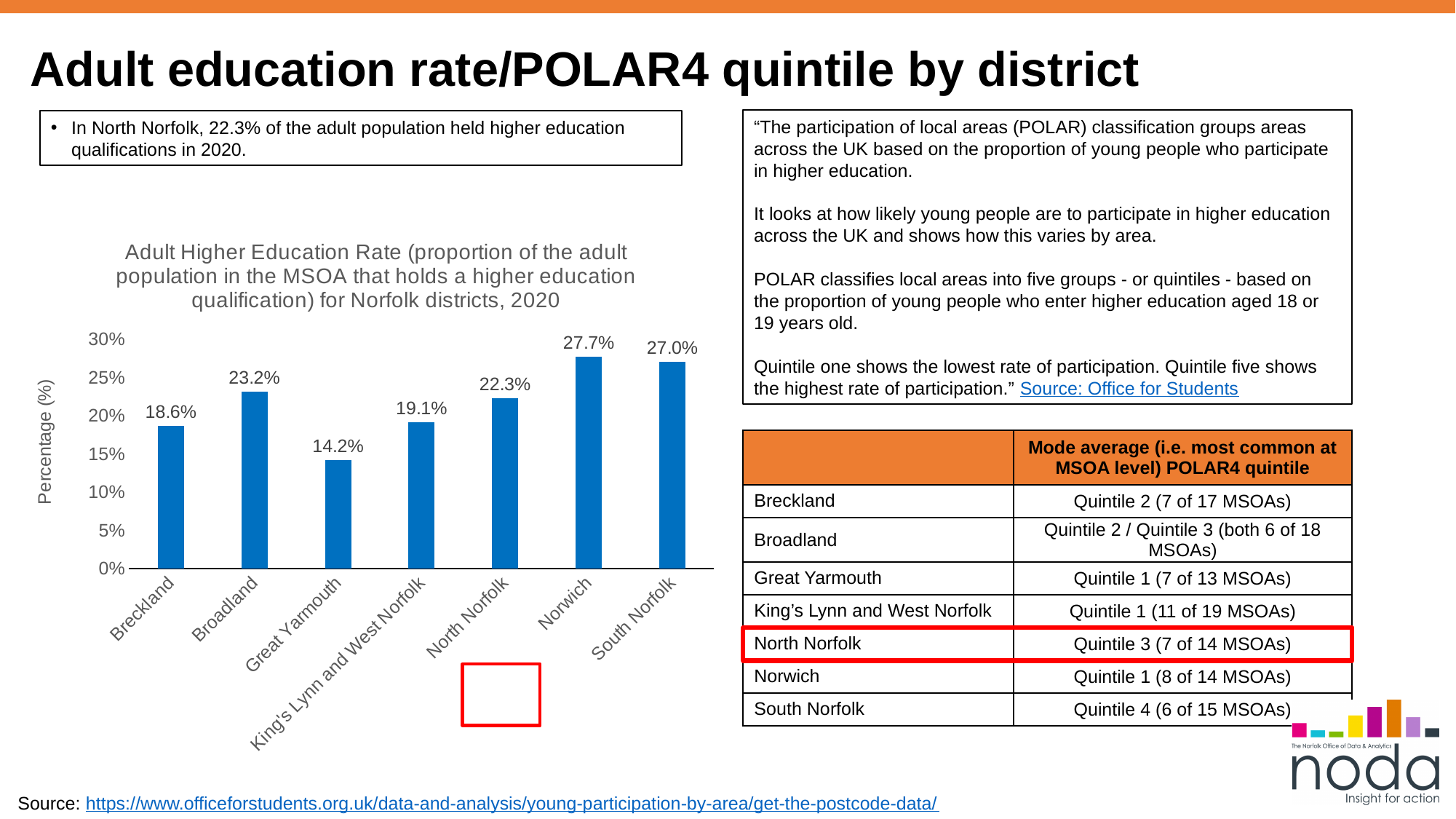
Which district has the highest adult higher education rate? Norwich What is the adult higher education rate for North Norfolk? 22.3% How many districts are shown in the bar chart? 7 What is the adult higher education rate for King's Lynn and West Norfolk? 19.1% Is the value for Breckland greater or less than 20%? less What is the label on the vertical axis of the chart? Percentage (%) Which district has the lowest adult higher education rate? Great Yarmouth Which has a higher adult higher education rate, Broadland or North Norfolk? Broadland What is the difference between the adult higher education rates of Norwich and South Norfolk? 0.7% What kind of chart is used to show the adult higher education rate by district? Bar chart What is the adult higher education rate for Great Yarmouth? 14.2% What is the difference between the adult higher education rates of Broadland and Breckland? 4.6%